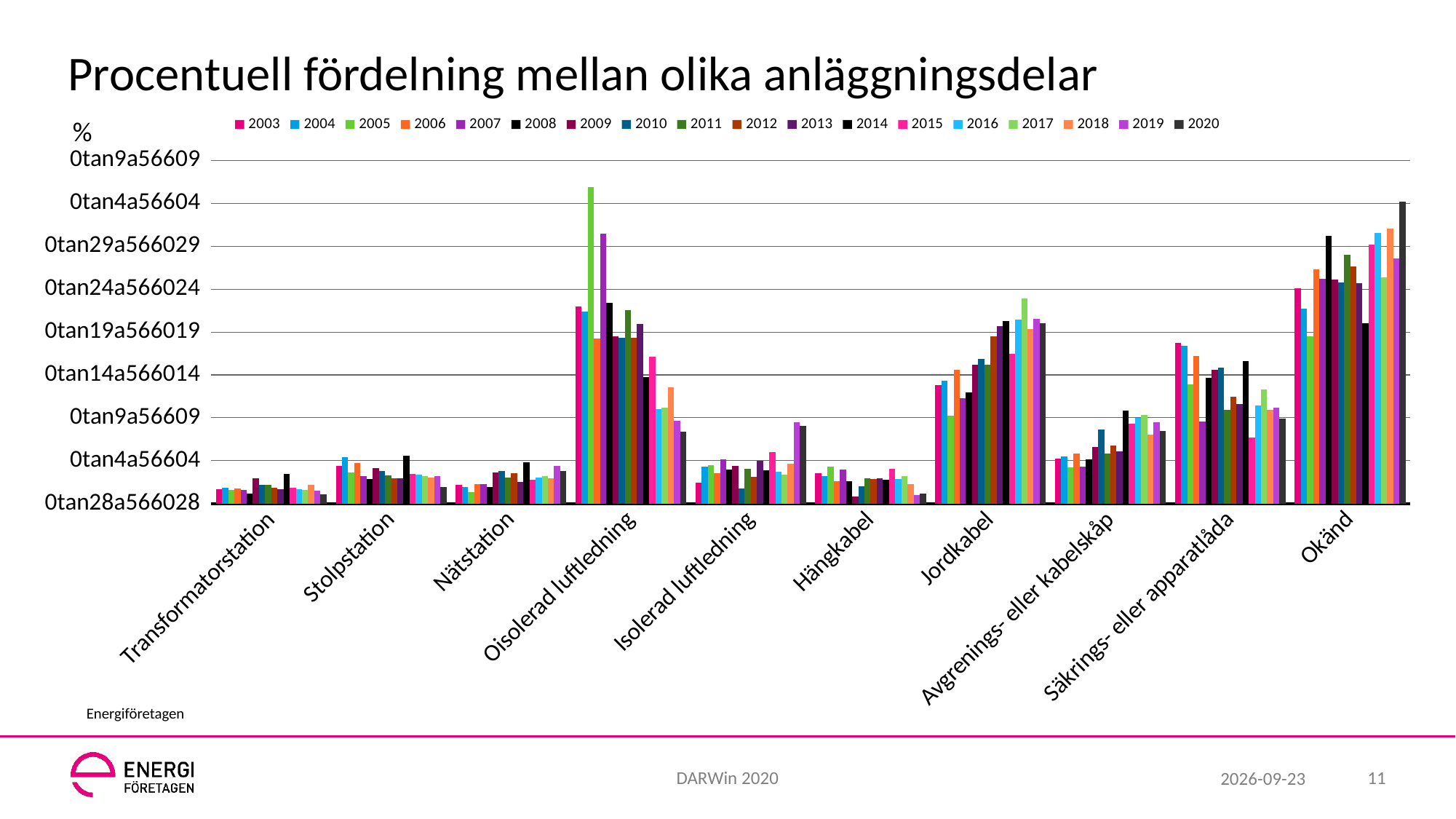
Within the Jordkabel category, which year has the highest bar? 2017 In the Oisolerad luftledning category, which is larger: the bar for 2003 or the bar for 2020? 2003 How many series does the chart's legend list? 18 Within the Okänd category, which year has the highest bar? 2020 Within the Oisolerad luftledning category, which year has the highest bar? 2005 What is the title of the chart? Procentuell fördelning mellan olika anläggningsdelar Which years are the first and last series listed in the legend? 2003 and 2020 For the year 2003, which is larger: the bar for Okänd or the bar for Transformatorstation? Okänd How many categories are shown along the x axis of the chart? 10 In the Jordkabel category, do the bars generally rise or fall from 2003 to 2020? rise What kind of chart is shown on the slide? bar chart